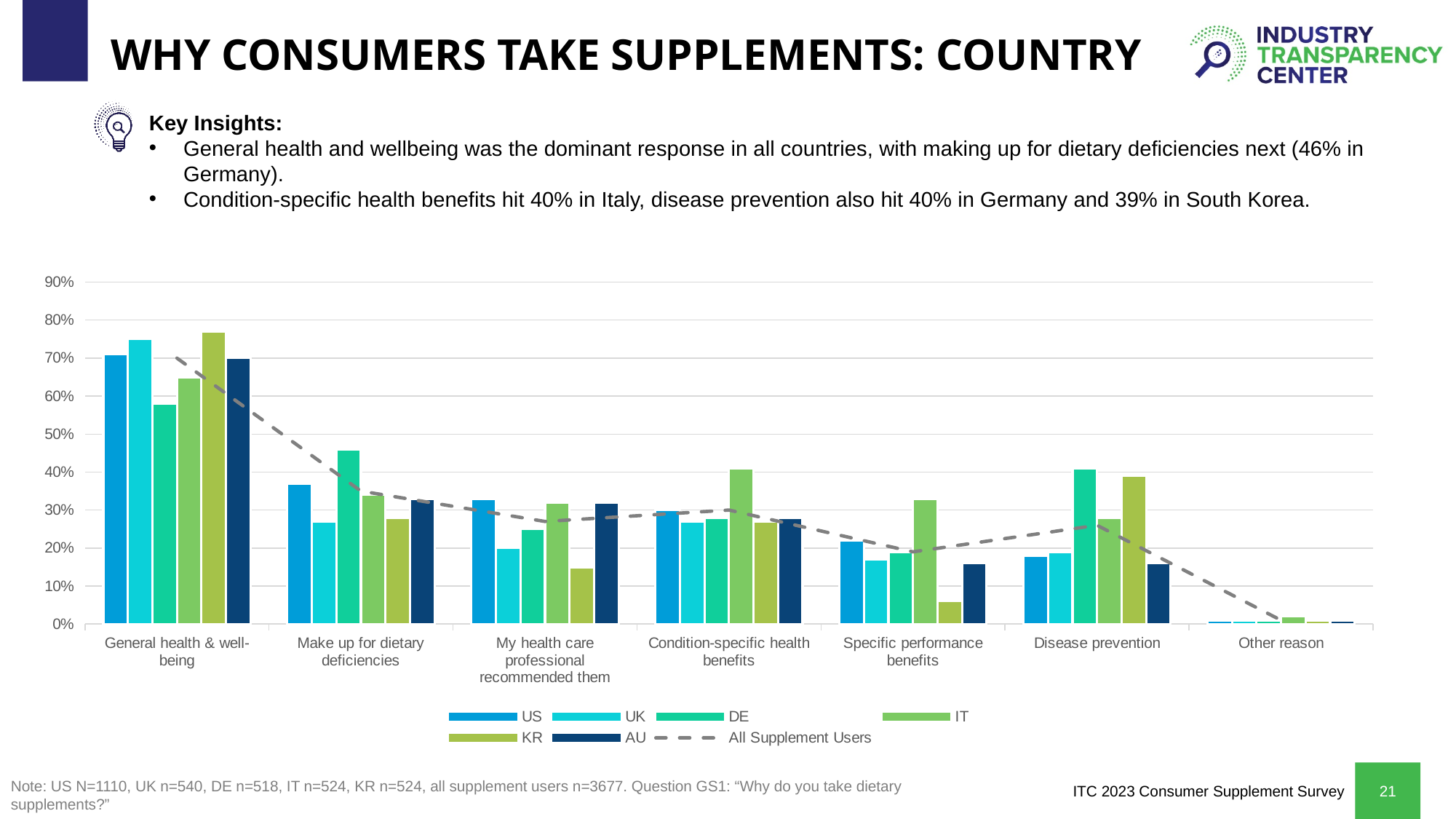
Which country has the highest bar for General health & well-being? KR Which is larger for My health care professional recommended them, IT or KR? IT How many entries does the legend list? 7 Which country has the lowest bar for General health & well-being? DE Which category has the lowest bars overall? Other reason Which category has the highest bars overall? General health & well-being What kind of chart is shown on the slide? combination bar and line chart Which country has the lowest bar for Specific performance benefits? KR Which country has the highest bar for Make up for dietary deficiencies? DE How many reason categories are shown on the x axis? 7 Is the value for DE in Make up for dietary deficiencies greater or less than 40%? greater Is the value for AU in Disease prevention greater or less than 20%? less